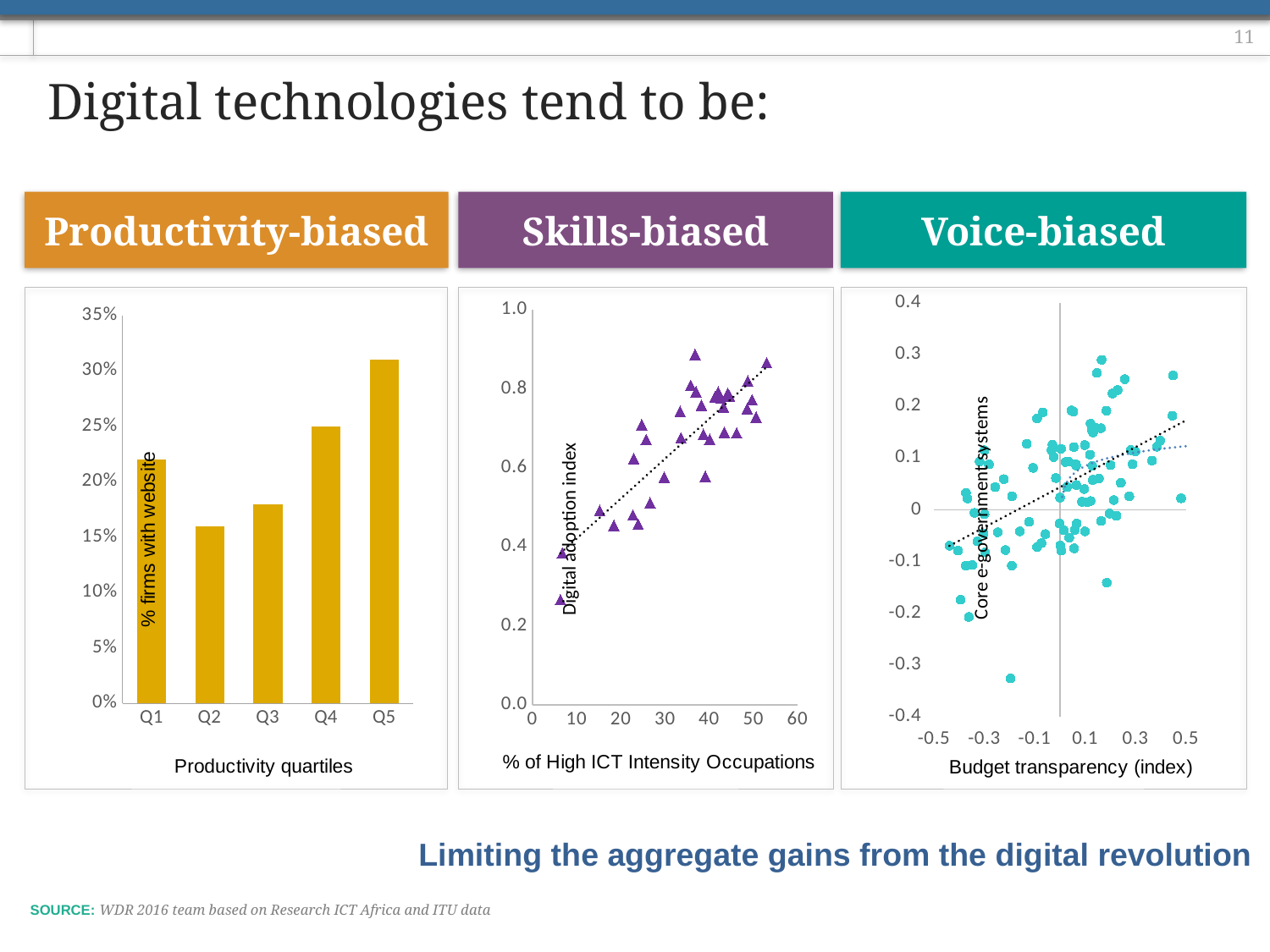
In the Productivity-biased bar chart, which has a larger share of firms with a website, Q1 or Q3? Q1 In the Skills-biased chart, what is the label of the x axis? % of High ICT Intensity Occupations In the Productivity-biased bar chart, is the value for Q2 greater or less than 20%? less In the Productivity-biased bar chart, which productivity quartile has the highest share of firms with a website? Q5 In the Productivity-biased bar chart, is the value for Q1 greater or less than 20%? greater In the Voice-biased chart, what is the label of the y axis? Core e-government systems What kind of chart is shown under the Productivity-biased heading? bar chart In the Productivity-biased bar chart, is the value for Q5 greater or less than 30%? greater In the Productivity-biased bar chart, which productivity quartile has the lowest share of firms with a website? Q2 In the Productivity-biased bar chart, which has a larger share of firms with a website, Q4 or Q5? Q5 What kind of chart is shown under the Skills-biased heading? scatter plot In the Productivity-biased bar chart, how many productivity quartiles are shown on the x axis? 5